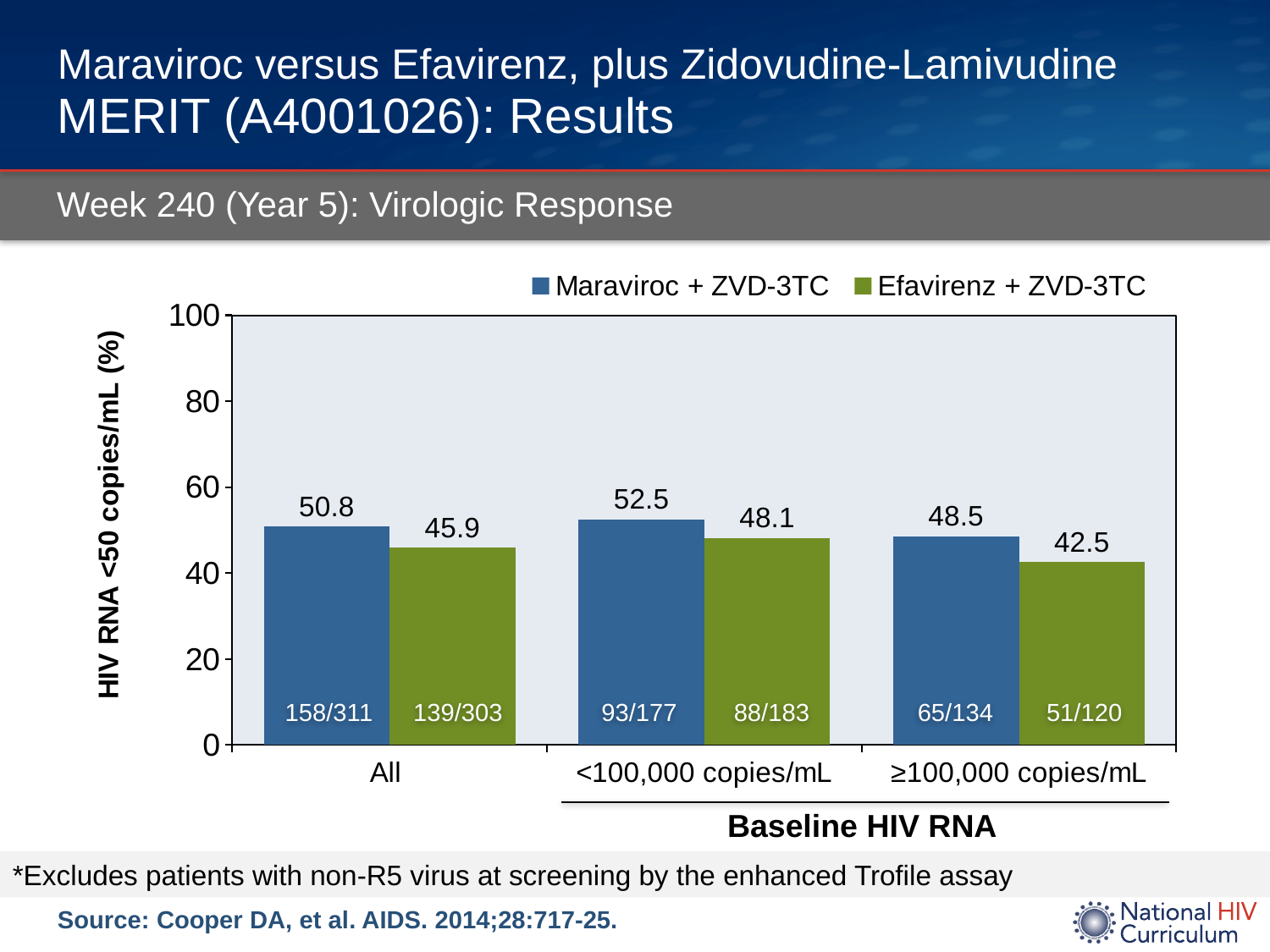
How many baseline HIV RNA categories are shown on the x axis? 3 What is the difference between the Maraviroc + ZVD-3TC and Efavirenz + ZVD-3TC values in the ≥100,000 copies/mL category? 6.0 What is the value for Maraviroc + ZVD-3TC in the All category? 50.8 What kind of chart is shown on the slide? Bar chart What fraction is printed inside the Maraviroc + ZVD-3TC bar for the All category? 158/311 In the <100,000 copies/mL category, which series has the larger value? Maraviroc + ZVD-3TC Which baseline HIV RNA category has the highest value for Maraviroc + ZVD-3TC? <100,000 copies/mL Which baseline HIV RNA category has the lowest value for Efavirenz + ZVD-3TC? ≥100,000 copies/mL What is the value for Efavirenz + ZVD-3TC in the ≥100,000 copies/mL category? 42.5 What is the value for Efavirenz + ZVD-3TC in the <100,000 copies/mL category? 48.1 What is the difference between the Maraviroc + ZVD-3TC and Efavirenz + ZVD-3TC values in the All category? 4.9 How many series does the legend list? 2